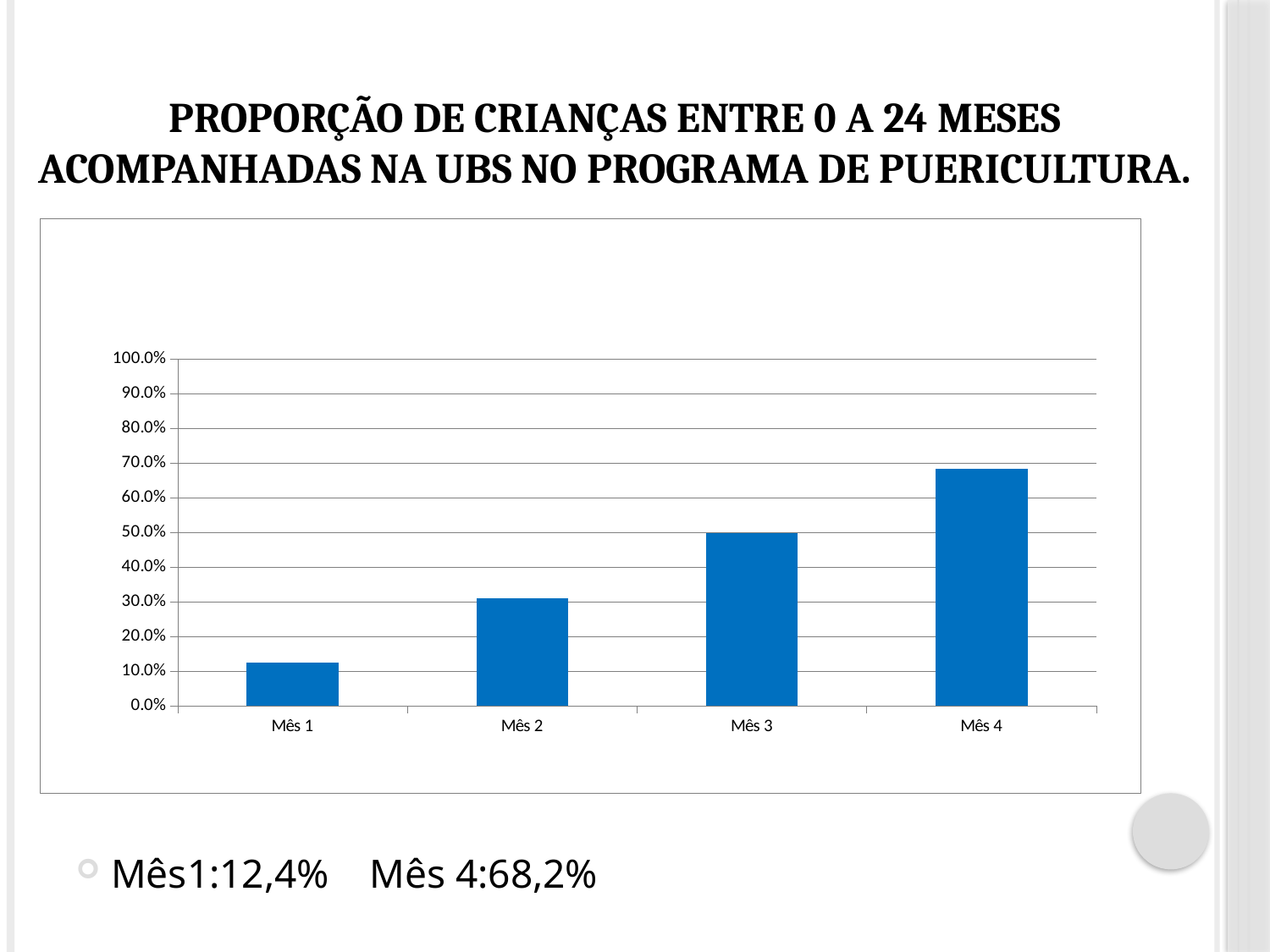
What kind of chart is shown on the slide? bar chart Is the value for Mês 4 greater or less than 60.0%? greater Which month has the highest value? Mês 4 Do the values rise or fall from Mês 1 to Mês 4? rise Which month has the lowest value? Mês 1 What is the value for Mês 4? 68,2% What is the value for Mês 1? 12,4% Is the value for Mês 2 greater or less than 40.0%? less Which is larger, the value for Mês 2 or the value for Mês 3? Mês 3 What is the difference between the values for Mês 4 and Mês 1? 55,8% Is the value for Mês 3 greater or less than 40.0%? greater How many months are shown on the x axis? 4